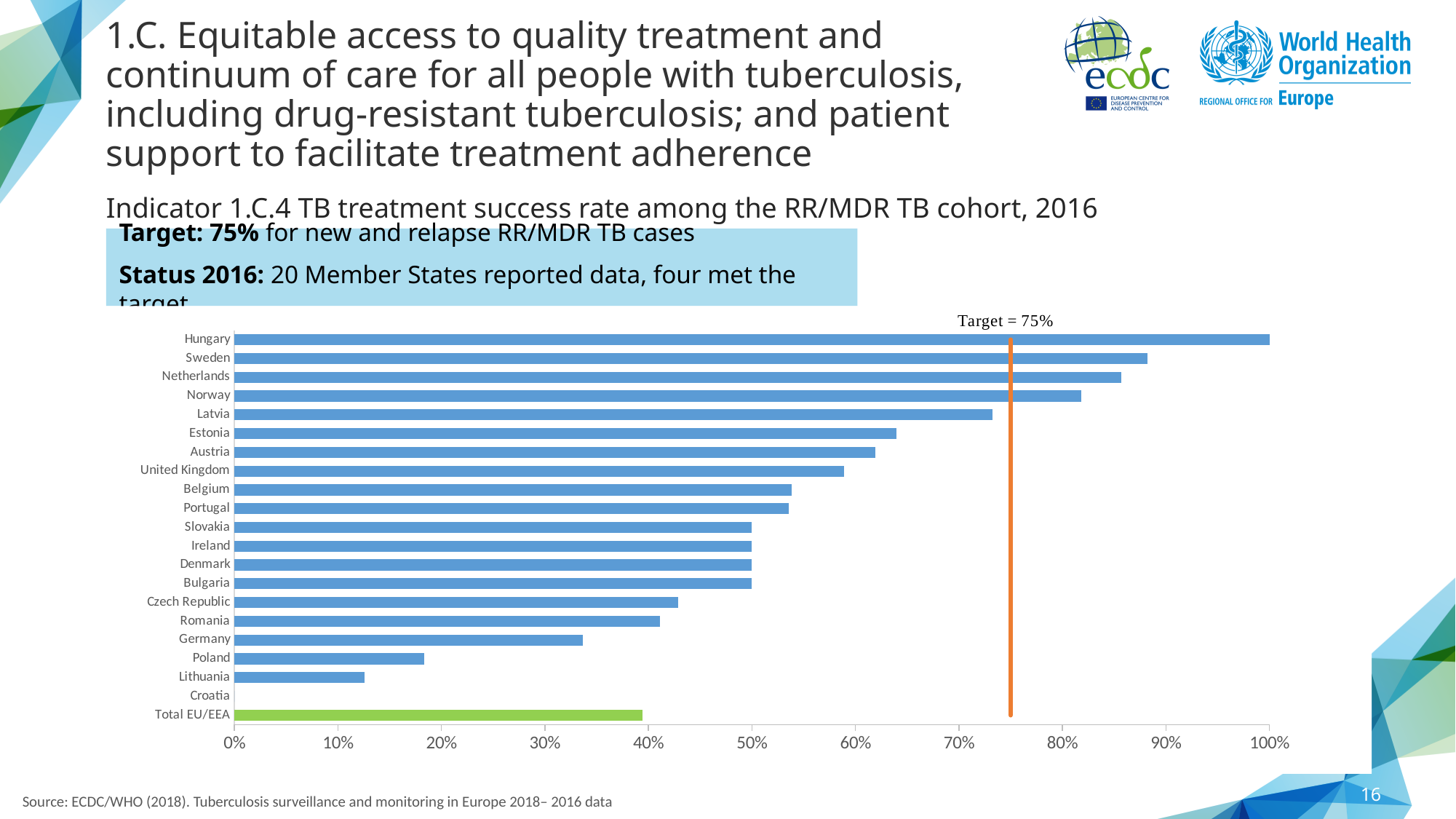
What target value is marked by the vertical orange line in the chart? 75% Is the value for Poland greater or less than 20%? less How many categories (bars) are listed on the y axis of the chart, including Total EU/EEA? 21 Is the value for Sweden greater or less than 80%? greater What is the treatment success rate shown for Hungary? 100% Is the value for Estonia greater or less than 60%? greater What is the treatment success rate shown for Slovakia? 50% What kind of chart is shown on the slide? bar chart Which has the higher treatment success rate, Romania or Germany? Romania Which has the higher treatment success rate, Norway or Latvia? Norway Which country has the highest TB treatment success rate in the chart? Hungary